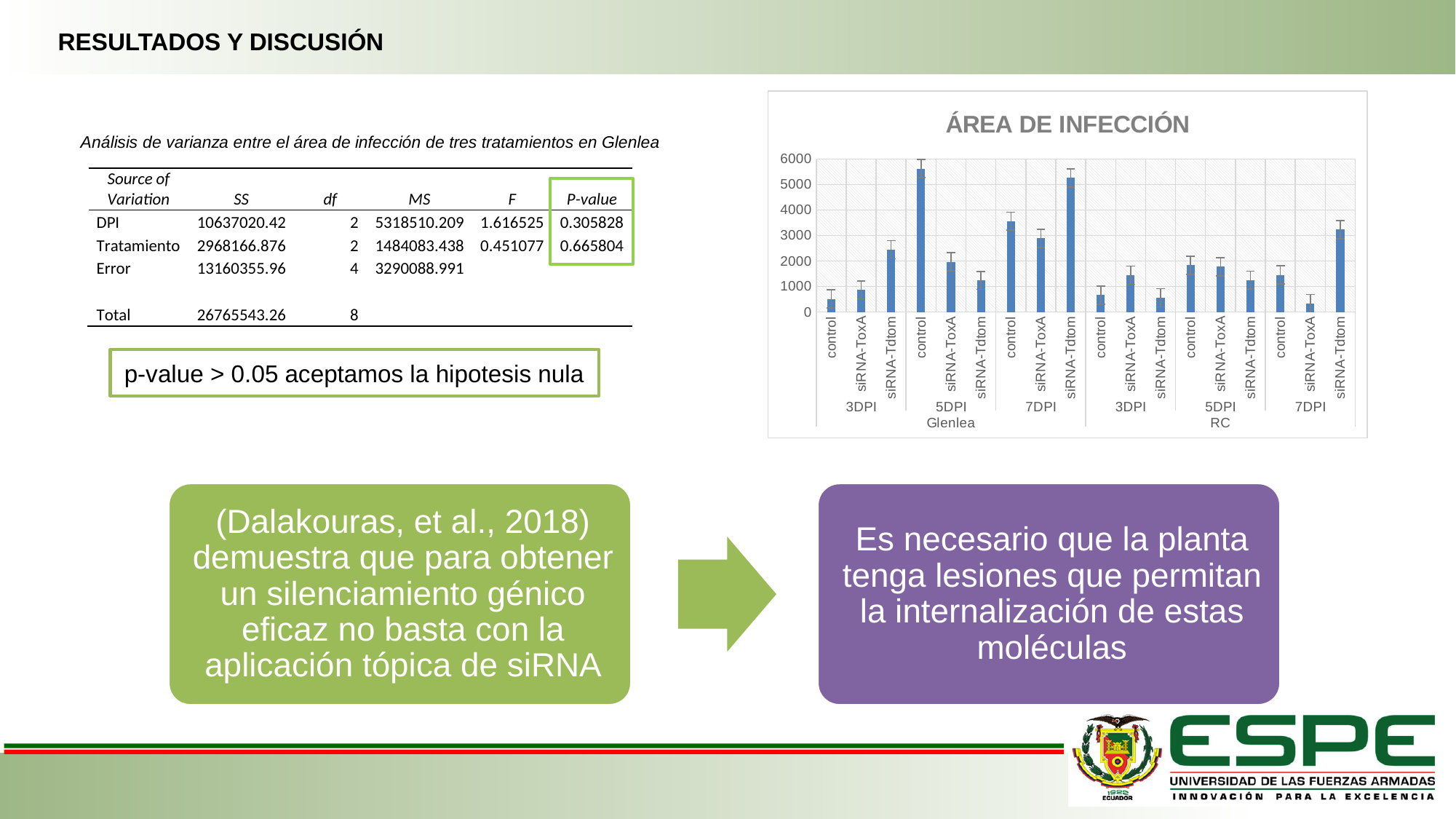
In the ÁREA DE INFECCIÓN chart, is the value for control at 3DPI in Glenlea greater or less than 1000? less In the ÁREA DE INFECCIÓN chart, is the value for control at 5DPI in Glenlea greater or less than 5000? greater In the ÁREA DE INFECCIÓN chart, which is larger: siRNA-ToxA at 3DPI in RC or siRNA-Tdtom at 3DPI in RC? siRNA-ToxA at 3DPI in RC What is the title of the chart on the slide? ÁREA DE INFECCIÓN What are the two top-level groups labelled on the x axis of the ÁREA DE INFECCIÓN chart? Glenlea and RC In the ÁREA DE INFECCIÓN chart, is the value for siRNA-ToxA at 7DPI in RC greater or less than 1000? less How many bars are plotted in the ÁREA DE INFECCIÓN chart? 18 Which bar in the ÁREA DE INFECCIÓN chart has the highest value? control, 5DPI, Glenlea In the ÁREA DE INFECCIÓN chart, which is larger: siRNA-Tdtom at 7DPI in Glenlea or siRNA-ToxA at 7DPI in Glenlea? siRNA-Tdtom at 7DPI in Glenlea In the ÁREA DE INFECCIÓN chart, which is larger: control at 5DPI in Glenlea or control at 5DPI in RC? control at 5DPI in Glenlea What kind of chart is shown on the slide? bar chart